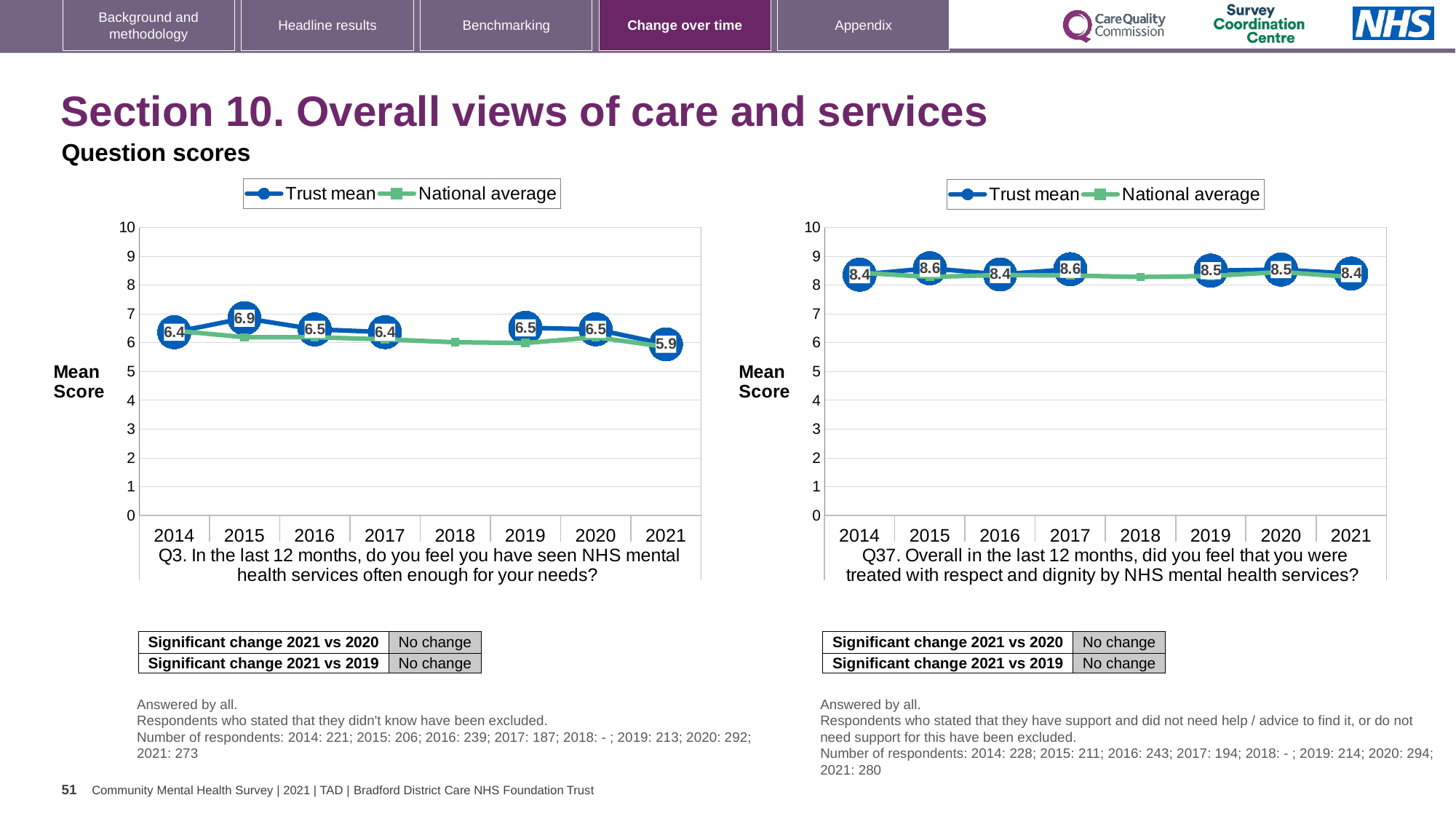
In the Q3 chart on the left, which year has the highest Trust mean score? 2015 What kind of chart is the Q3 chart on the left? Line chart In the Q37 chart on the right, what is the Trust mean score for 2017? 8.6 In the Q3 chart on the left, does the Trust mean rise or fall from 2020 to 2021? fall How many series does the legend of the Q37 chart on the right list? 2 In the Q3 chart on the left, is the National average for 2018 greater or less than 5? greater In the Q37 chart on the right, is the Trust mean score for 2015 larger or smaller than the score for 2016? larger In the Q37 chart on the right, what is the Trust mean score for 2019? 8.5 In the Q3 chart on the left, which year has the lowest Trust mean score? 2021 In the Q3 chart on the left, what is the difference between the Trust mean scores for 2015 and 2021? 1.0 In the Q3 chart on the left, what is the Trust mean score for 2021? 5.9 In the Q3 chart on the left, what is the Trust mean score for 2015? 6.9